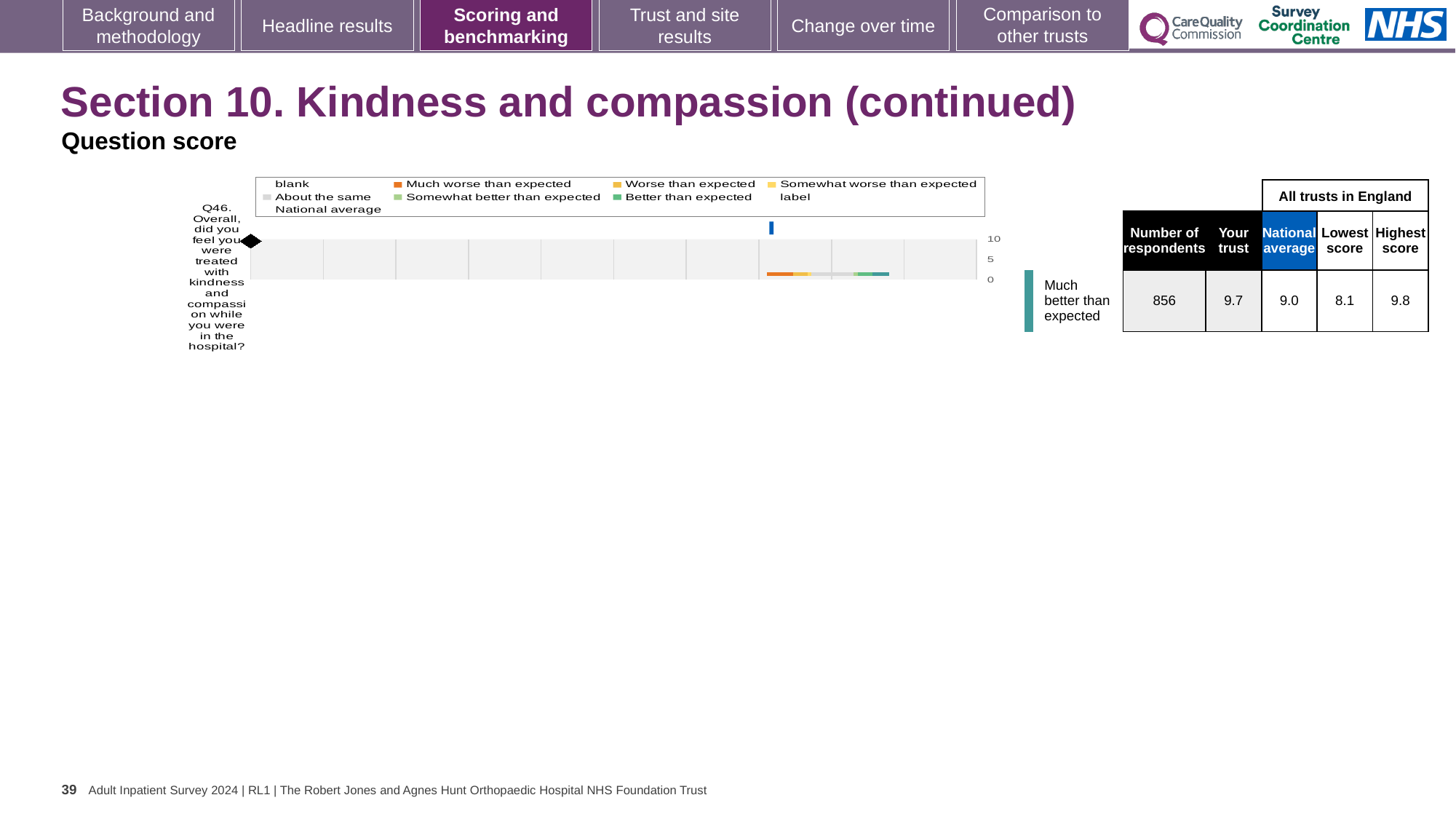
Which survey question is plotted on the chart? Q46. Overall, did you feel you were treated with kindness and compassion while you were in the hospital? What is the National average score for Q46? 9.0 What kind of chart is shown on the slide? Bar chart What is the difference between Your trust score and the National average for Q46? 0.7 Which is higher for Q46, Your trust score or the National average? Your trust How many respondents answered Q46? 856 What is the score for Your trust on Q46? 9.7 What is the Lowest score among all trusts in England for Q46? 8.1 How is the trust's result for Q46 categorised relative to expectation? Much better than expected How many questions are plotted on the chart? 1 What is the Highest score among all trusts in England for Q46? 9.8 What is the difference between the Highest score and the Lowest score for Q46? 1.7